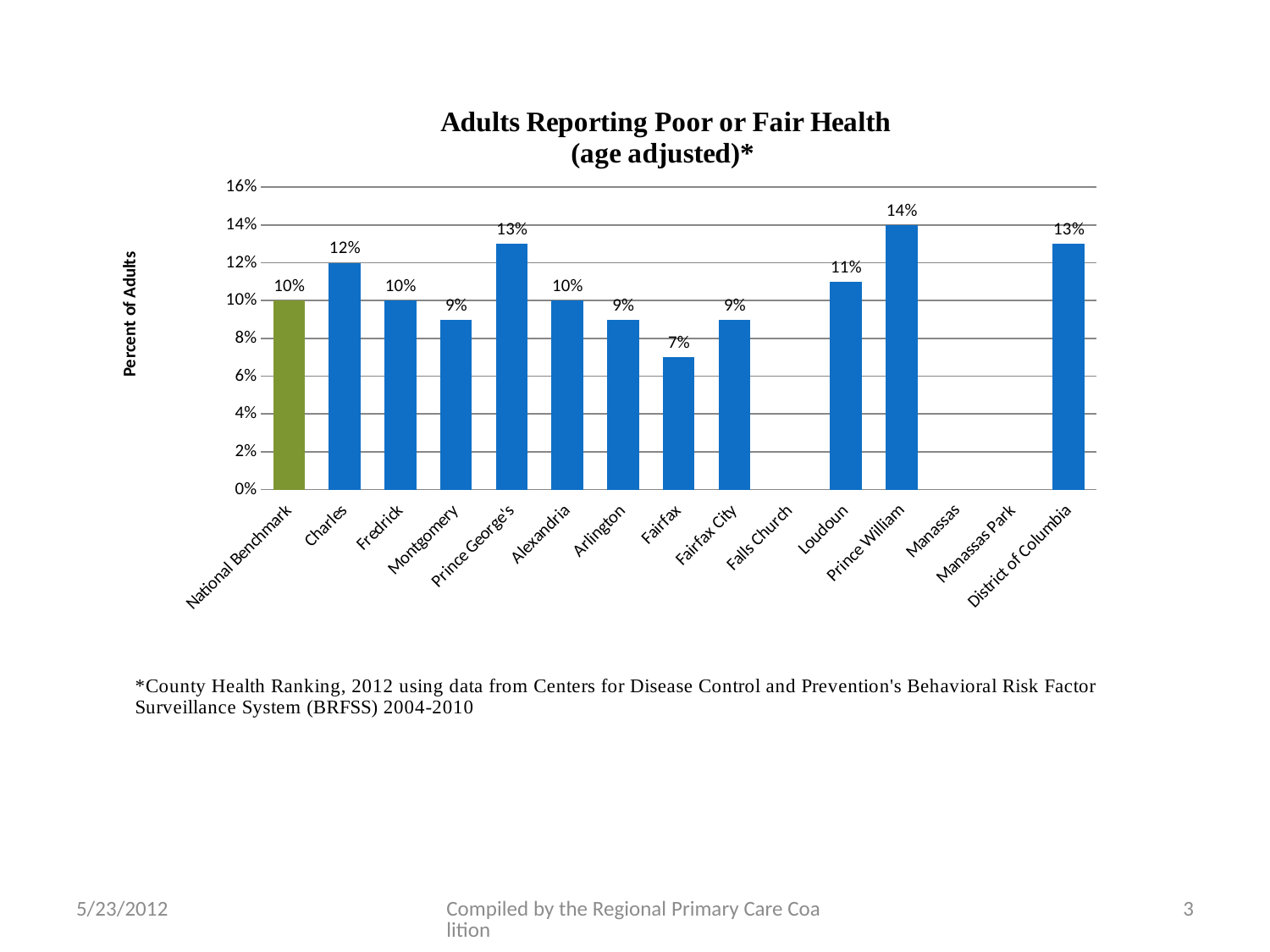
Which category has the highest value? Prince William Which is larger, the value for Charles or the value for Montgomery? Charles Which category with a plotted bar has the lowest value? Fairfax What is the value for the National Benchmark? 10% What is the value for Fairfax? 7% What is the difference between the values for Prince William and Fairfax? 7% What is the label on the vertical axis? Percent of Adults Which categories on the x axis have no bar plotted? Falls Church, Manassas, Manassas Park What type of chart is shown on the slide? bar chart How many categories are listed along the x axis? 15 What is the value for Loudoun? 11% What is the value for Prince William? 14%